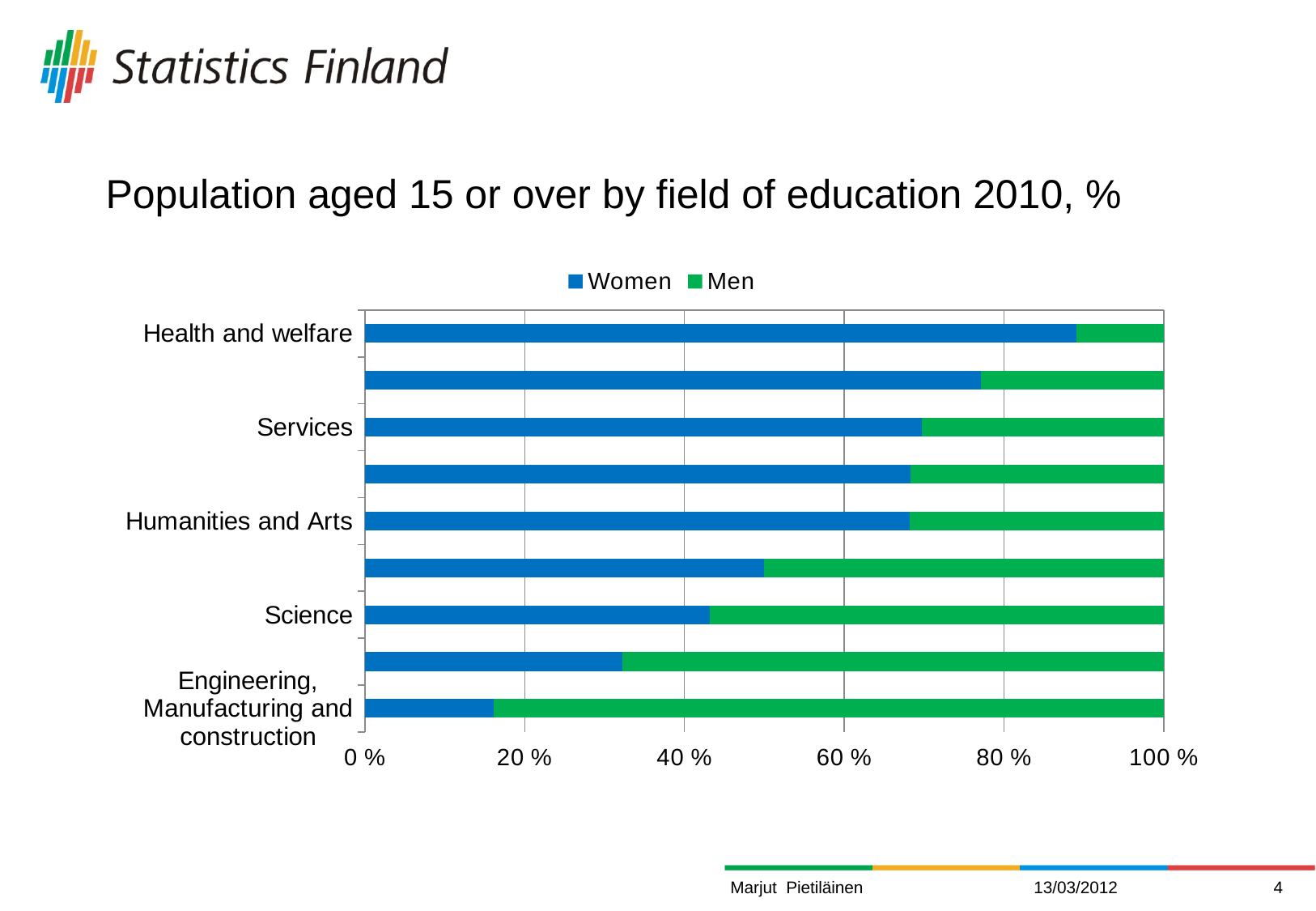
Which has the larger share of women, Science or Engineering, Manufacturing and construction? Science What kind of chart is shown on the slide? Stacked bar chart What is the title of the chart? Population aged 15 or over by field of education 2010, % Is the Women share for Health and welfare greater or less than 80 %? greater Is the Women share for Engineering, Manufacturing and construction greater or less than 20 %? less What are the two series named in the legend? Women and Men How many series does the legend list? 2 Is the Women share for Services greater or less than 60 %? greater How many bars are plotted in the chart? 9 Which labelled field of education has the highest share of women? Health and welfare Which labelled field of education has the lowest share of women? Engineering, Manufacturing and construction